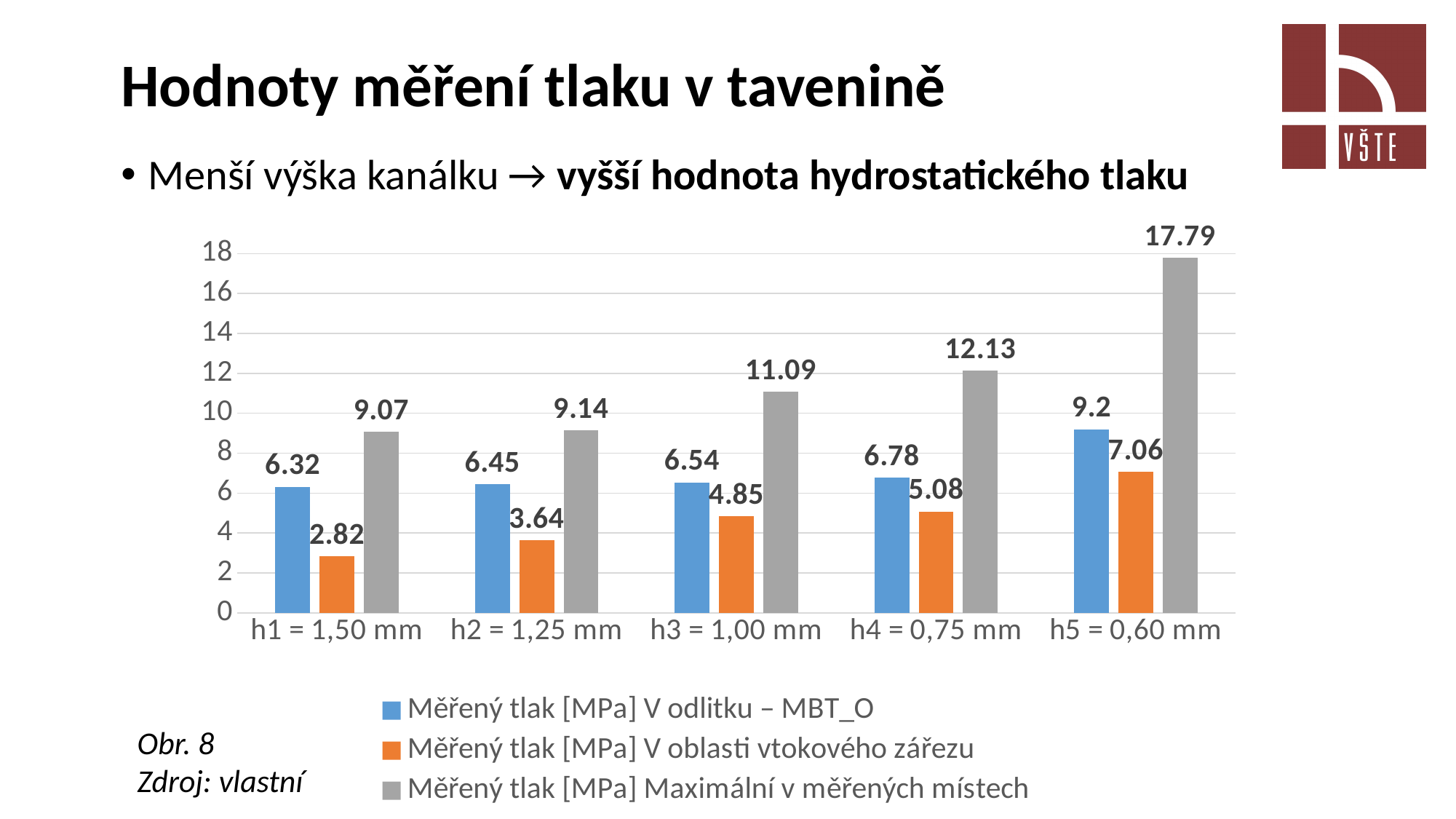
What colour are the bars for 'Měřený tlak [MPa] Maximální v měřených místech'? Grey What is the value of 'Měřený tlak [MPa] Maximální v měřených místech' for h5 = 0,60 mm? 17.79 How many categories are shown on the x axis? 5 What is the value of 'Měřený tlak [MPa] V odlitku – MBT_O' for h1 = 1,50 mm? 6.32 What is the difference between the 'Maximální v měřených místech' values for h5 = 0,60 mm and h4 = 0,75 mm? 5.66 What is the value of 'Měřený tlak [MPa] V oblasti vtokového zářezu' for h3 = 1,00 mm? 4.85 Which is larger for h2 = 1,25 mm: 'V odlitku – MBT_O' or 'V oblasti vtokového zářezu'? V odlitku – MBT_O What kind of chart is shown on the slide? Bar chart Do the values for 'Měřený tlak [MPa] V odlitku – MBT_O' rise or fall from h1 = 1,50 mm to h5 = 0,60 mm? Rise How many series does the legend list? 3 Which category has the lowest value for 'Měřený tlak [MPa] V oblasti vtokového zářezu'? h1 = 1,50 mm Which category has the highest value for 'Měřený tlak [MPa] Maximální v měřených místech'? h5 = 0,60 mm